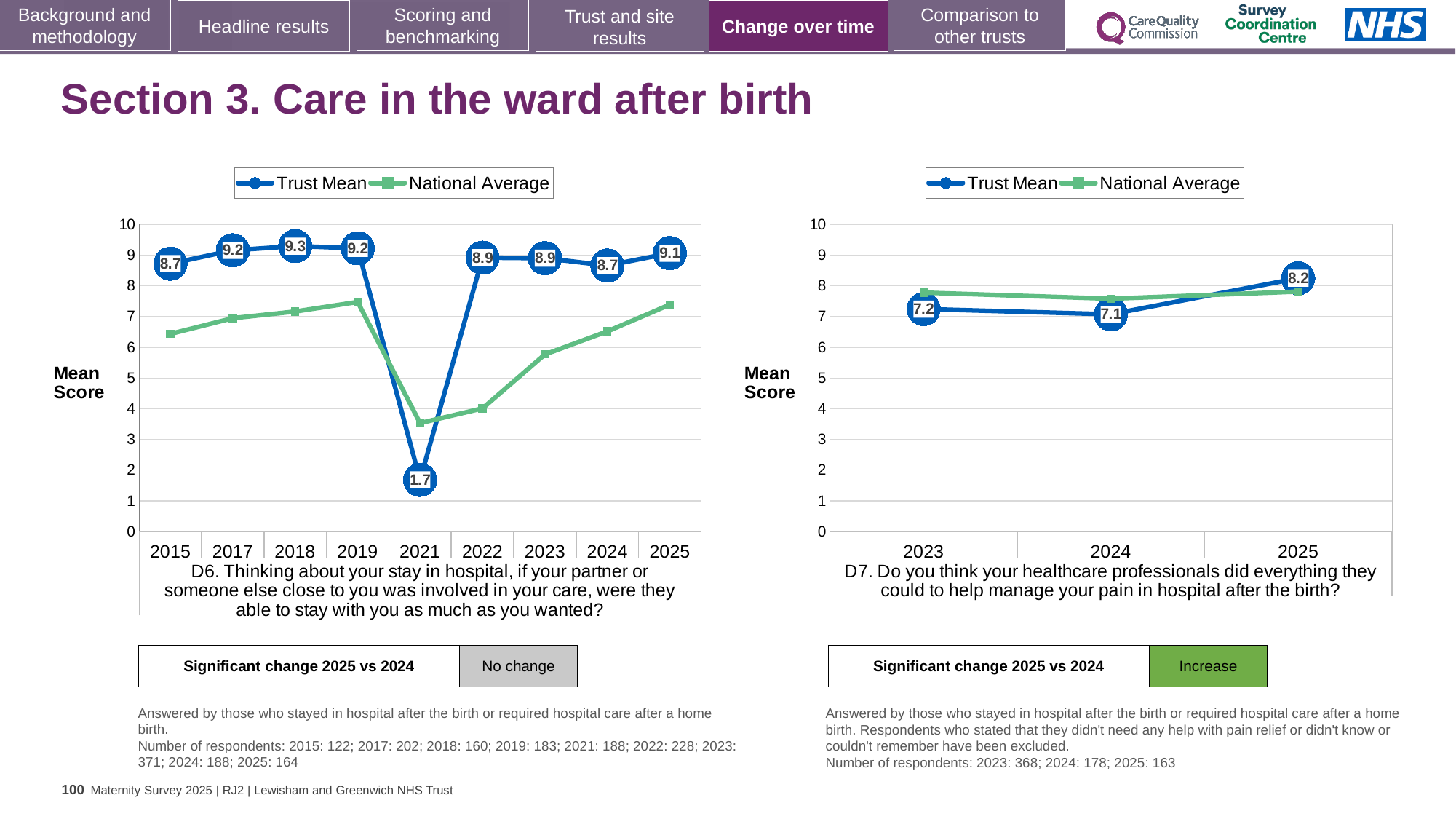
In the D6 chart on the left, which year has the highest Trust Mean score? 2018 In the D7 chart on the right, is the Trust Mean for 2024 larger or smaller than the Trust Mean for 2025? smaller In the D6 chart on the left, how many years are shown on the x axis? 9 In the D6 chart on the left, what is the difference between the Trust Mean scores for 2022 and 2021? 7.2 In the D7 chart on the right, how many series does the legend list? 2 In the D6 chart on the left, what is the Trust Mean score for 2025? 9.1 In the D7 chart on the right, what is the difference between the Trust Mean scores for 2025 and 2024? 1.1 In the D7 chart on the right, what is the Trust Mean score for 2025? 8.2 What type of chart is the D7 chart on the right? Line chart In the D6 chart on the left, is the National Average for 2021 greater or less than 4? less In the D6 chart on the left, what is the Trust Mean score for 2021? 1.7 In the D6 chart on the left, which year has the lowest Trust Mean score? 2021